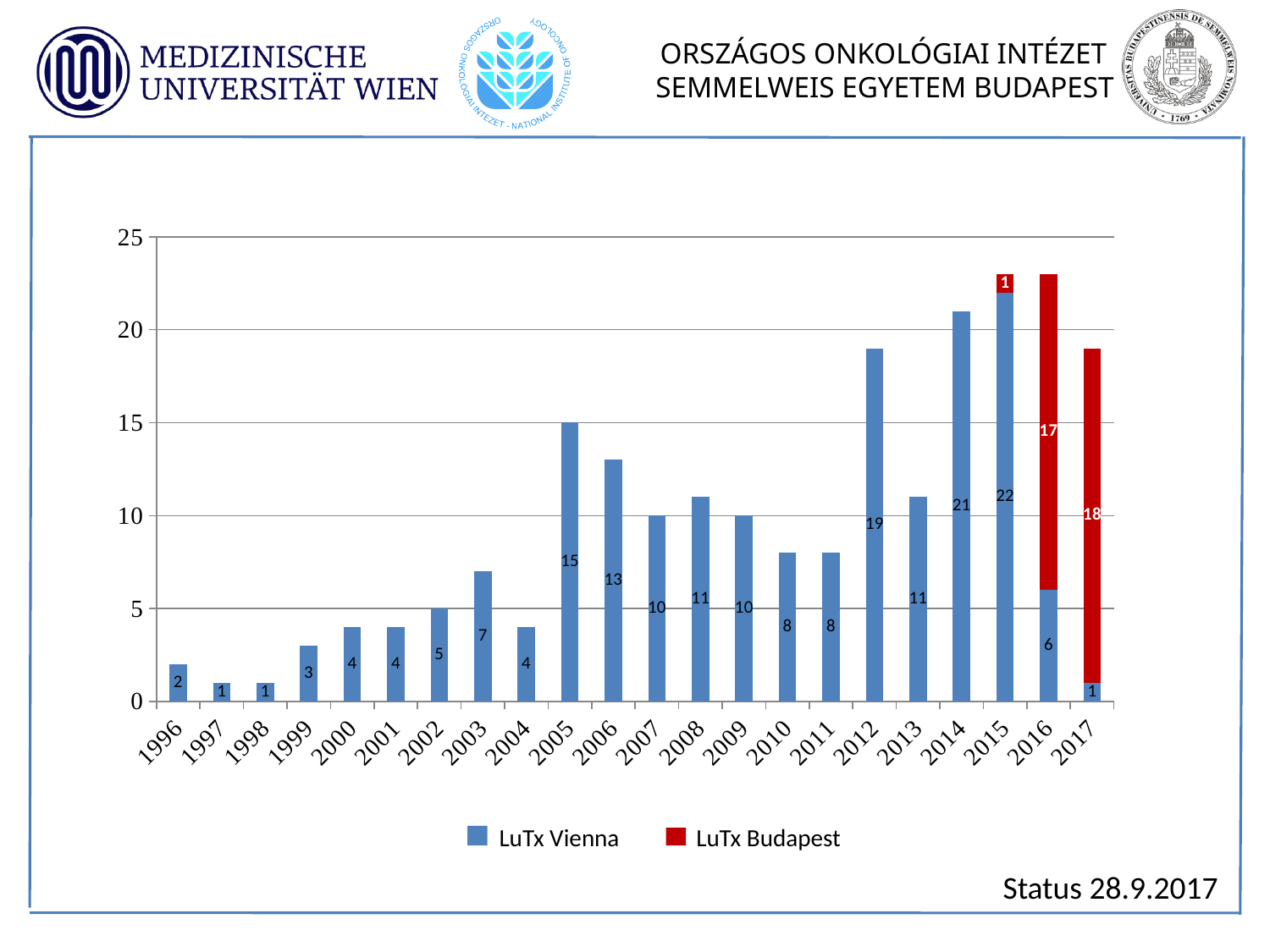
In which year is the LuTx Vienna value highest? 2015 How many series does the legend list? 2 Which is larger, the LuTx Vienna value for 2006 or for 2012? 2012 What is the value for LuTx Vienna in 2005? 15 What kind of chart is shown on the slide? Stacked bar chart What is the total height of the stacked bar for 2017? 19 What is the value for LuTx Vienna in 2017? 1 Which colour represents LuTx Budapest in the chart? Red What is the difference between the LuTx Vienna values for 2014 and 2013? 10 How many years are shown on the x axis? 22 What is the total height of the stacked bar for 2016? 23 What is the value for LuTx Budapest in 2016? 17